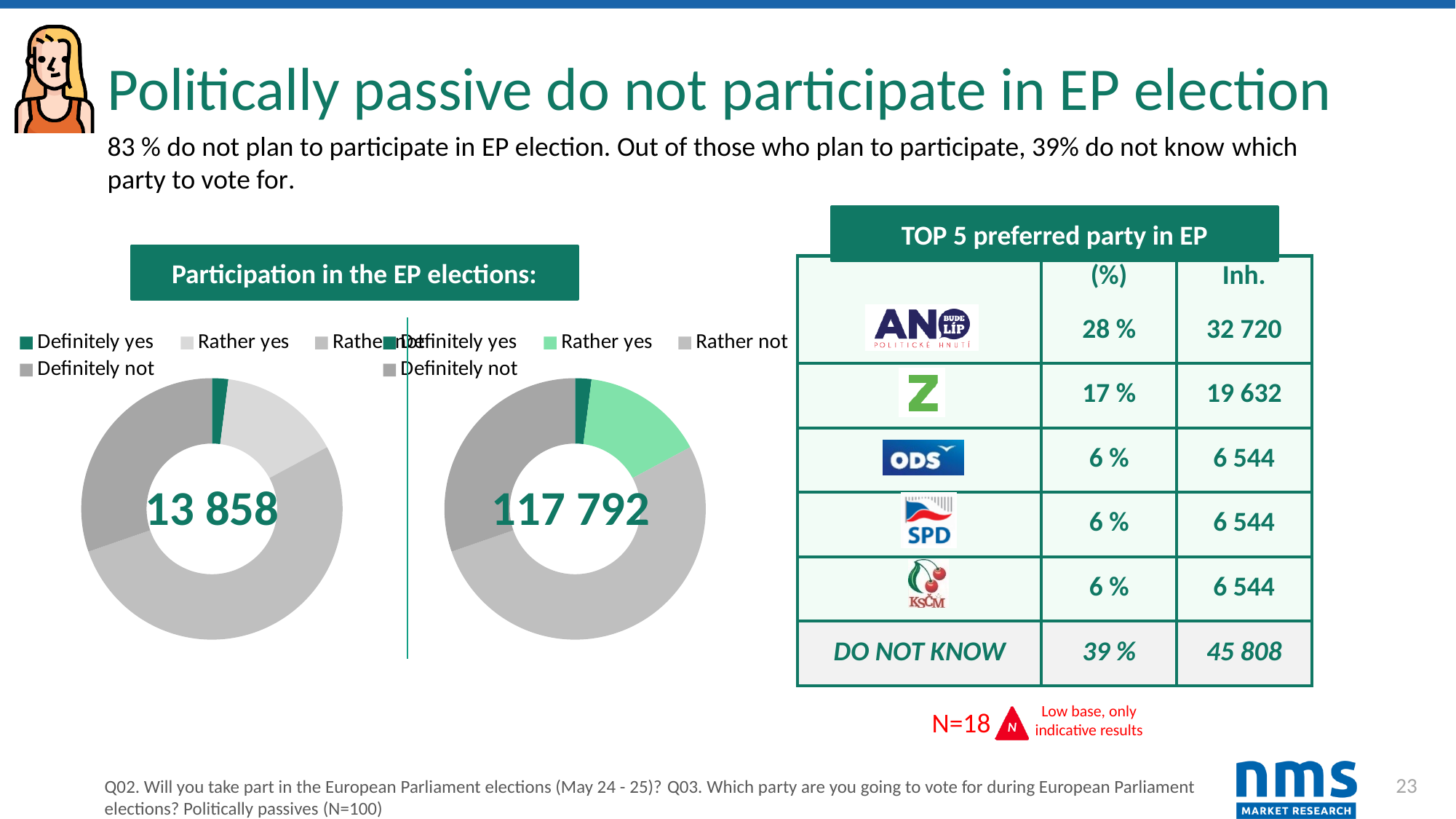
What kind of chart is the left chart under 'Participation in the EP elections:'? doughnut chart In the left pie chart, which slice is larger: Rather not or Definitely yes? Rather not What colour is the 'Rather yes' slice in the right pie chart? light green In the left pie chart, which category has the smallest slice? Definitely yes In the right pie chart, which category has the smallest slice? Definitely yes What is the title shown above the two pie charts? Participation in the EP elections: In the 'TOP 5 preferred party in EP' table, what percentage is shown for ANO? 28 % How many slices does the right pie chart have? 4 What number is printed in the centre of the right pie chart? 117 792 What number is printed in the centre of the left pie chart? 13 858 How many entries does the legend of the left pie chart list? 4 In the right pie chart, which slice is larger: Rather yes or Definitely yes? Rather yes